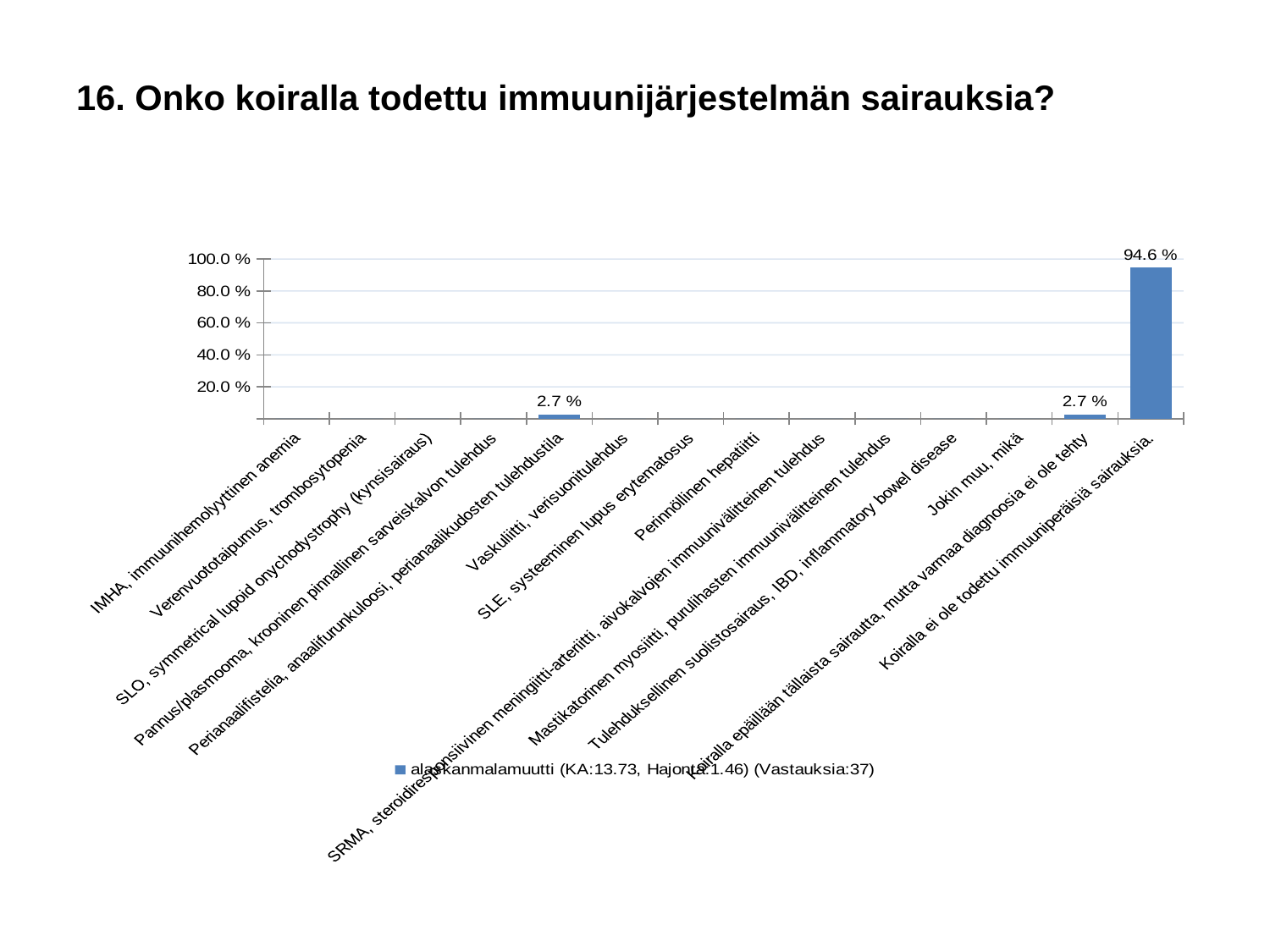
What is the difference between the value for "Koiralla ei ole todettu immuuniperäisiä sairauksia." and the value for "Koiralla epäillään tällaista sairautta, mutta varmaa diagnoosia ei ole tehty"? 91.9 % What is the value for "Koiralla epäillään tällaista sairautta, mutta varmaa diagnoosia ei ole tehty"? 2.7 % How many series does the legend list? 1 Is the value for "Perianaalifistelia, anaalifurunkuloosi, perianaalikudosten tulehdustila" greater or less than 20.0 %? less What is the title of the slide? 16. Onko koiralla todettu immuunijärjestelmän sairauksia? Which is larger: the value for "Koiralla ei ole todettu immuuniperäisiä sairauksia." or the value for "Perianaalifistelia, anaalifurunkuloosi, perianaalikudosten tulehdustila"? Koiralla ei ole todettu immuuniperäisiä sairauksia. Is the value for "Koiralla ei ole todettu immuuniperäisiä sairauksia." greater or less than 80.0 %? greater What kind of chart is shown on the slide? bar chart Which category has the highest value? Koiralla ei ole todettu immuuniperäisiä sairauksia. What is the value for "Koiralla ei ole todettu immuuniperäisiä sairauksia."? 94.6 % How many categories are shown on the x axis? 14 What is the value for "Perianaalifistelia, anaalifurunkuloosi, perianaalikudosten tulehdustila"? 2.7 %